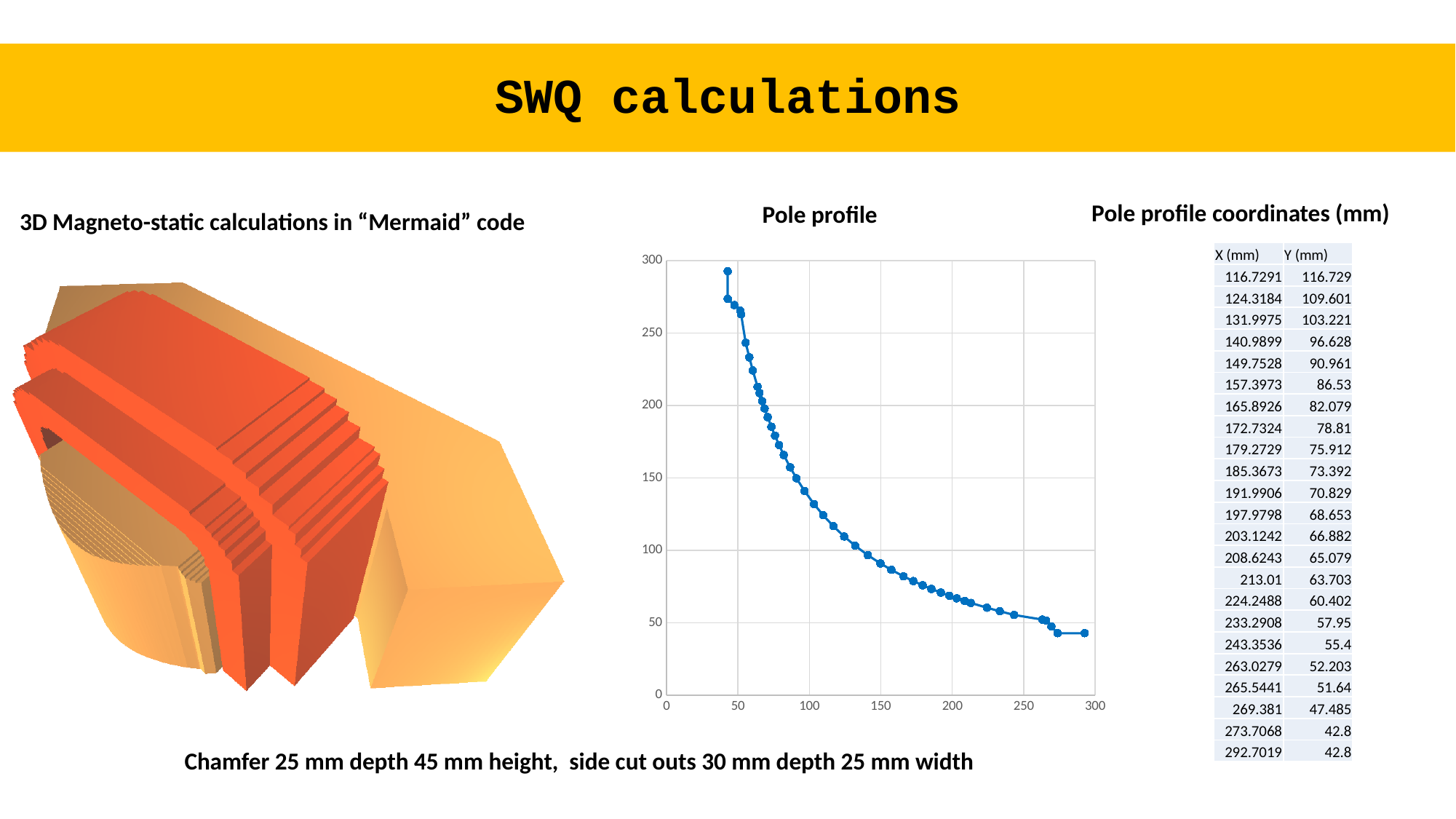
In the "Pole profile" chart, is the plotted value at x = 150 greater or less than 100? less In the "Pole profile" chart, do the plotted values rise or fall as the x value increases? fall What is the title of the chart on the slide? Pole profile In the "Pole profile" chart, is the plotted value at x = 50 greater or less than 250? greater In the "Pole profile" chart, is the lowest plotted value greater or less than 50? less How many data series are plotted in the "Pole profile" chart? 1 What type of chart is the "Pole profile" chart? line chart What is the maximum value shown on the vertical axis of the "Pole profile" chart? 300